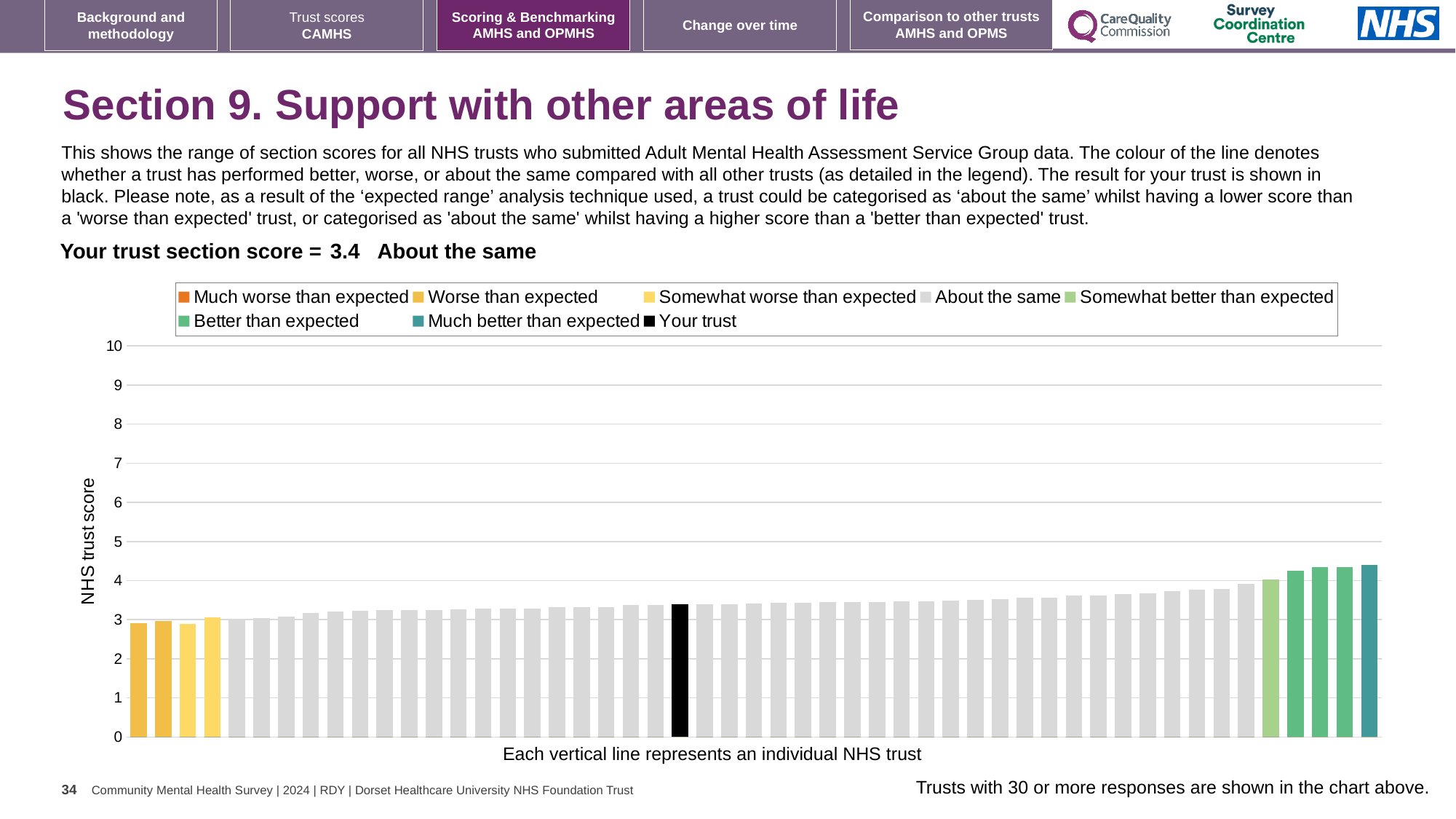
Which legend category do the tallest bars at the right of the chart belong to? Much better than expected Is the value of the black 'Your trust' bar greater or less than 3? greater Is the value of the tallest bar in the chart greater or less than 4? greater Do the bar values rise or fall from left to right along the x axis? rise Which performance category is your trust placed in for this section? About the same What is the section score for your trust shown on the slide? 3.4 How many entries does the chart legend list? 8 Is the value of the tallest bar in the chart greater or less than 5? less What is the label on the vertical axis of the chart? NHS trust score What kind of chart is shown on the slide? bar chart What colour is used for the 'Your trust' bar in the chart? black